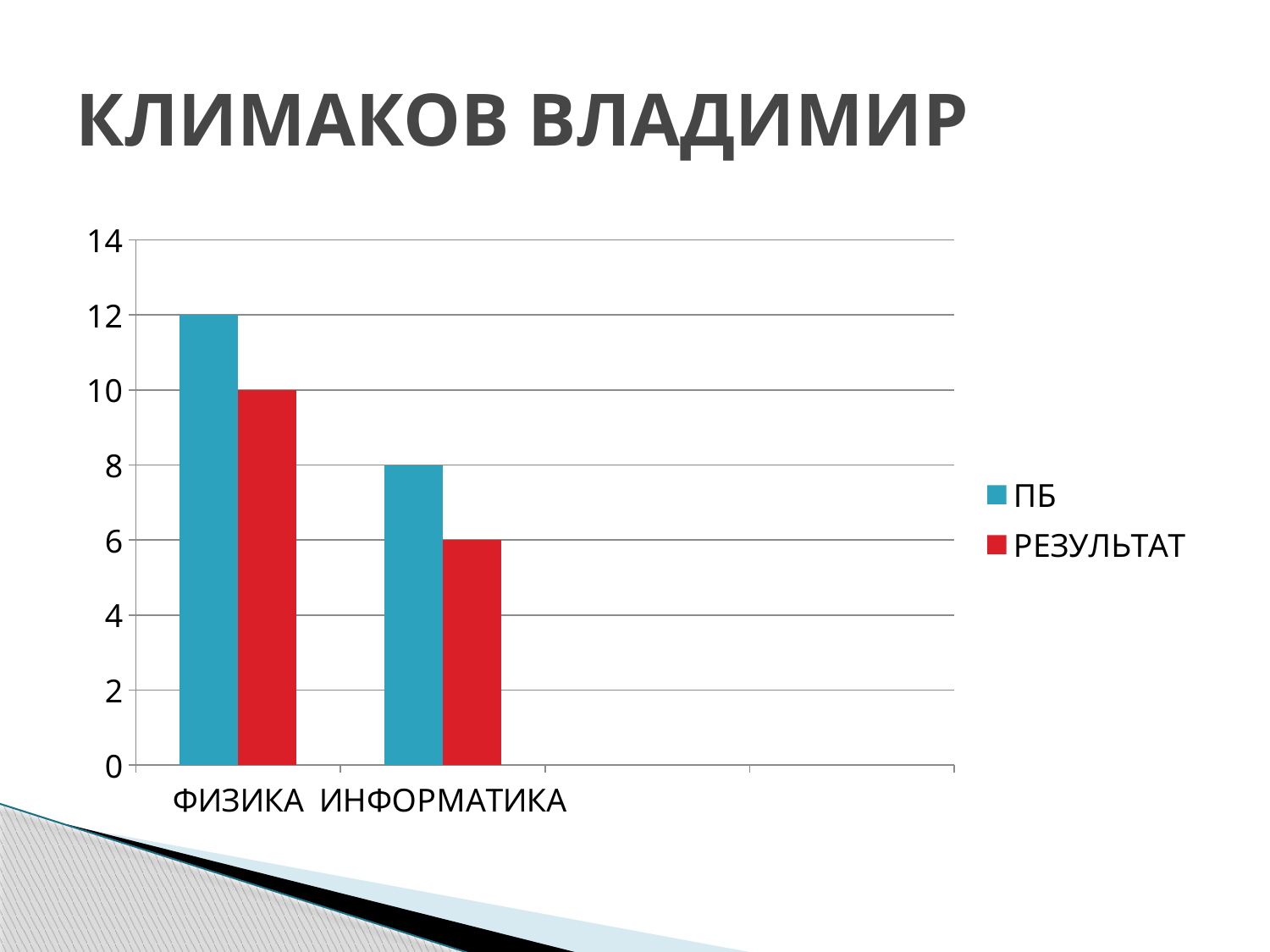
How many categories are shown on the x axis? 2 What is the РЕЗУЛЬТАТ value for ИНФОРМАТИКА? 6 What is the difference between the ПБ and РЕЗУЛЬТАТ values for ФИЗИКА? 2 What is the ПБ value for ФИЗИКА? 12 What kind of chart is shown on the slide? Bar chart Which category has the lowest РЕЗУЛЬТАТ value? ИНФОРМАТИКА What is the ПБ value for ИНФОРМАТИКА? 8 How many series does the legend list? 2 Which category has the highest ПБ value? ФИЗИКА What is the difference between the ПБ values for ФИЗИКА and ИНФОРМАТИКА? 4 What is the РЕЗУЛЬТАТ value for ФИЗИКА? 10 Which is larger: the РЕЗУЛЬТАТ value for ФИЗИКА or the ПБ value for ИНФОРМАТИКА? РЕЗУЛЬТАТ for ФИЗИКА